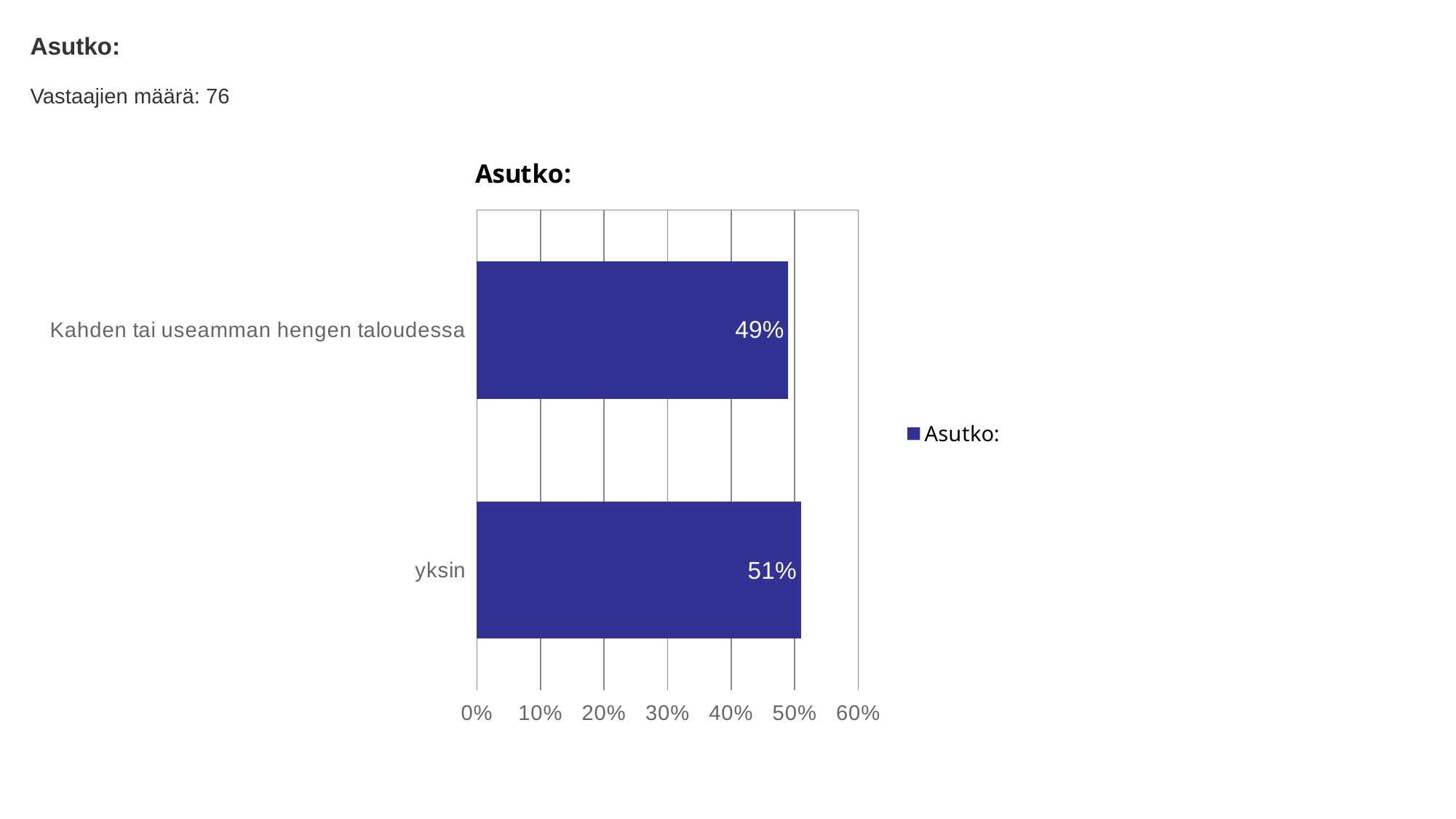
Which category has the lowest value? Kahden tai useamman hengen taloudessa Which category has the highest value? yksin How many series does the legend list? 1 Is the value for "yksin" greater or less than 40%? greater What kind of chart is shown on the slide? bar chart What is the title of the chart? Asutko: What is the value for "yksin"? 51% Which is larger: the value for "yksin" or for "Kahden tai useamman hengen taloudessa"? yksin What is the value for "Kahden tai useamman hengen taloudessa"? 49% Is the value for "Kahden tai useamman hengen taloudessa" greater or less than 50%? less What is the difference between the values for "yksin" and "Kahden tai useamman hengen taloudessa"? 2% How many categories are shown in the chart? 2